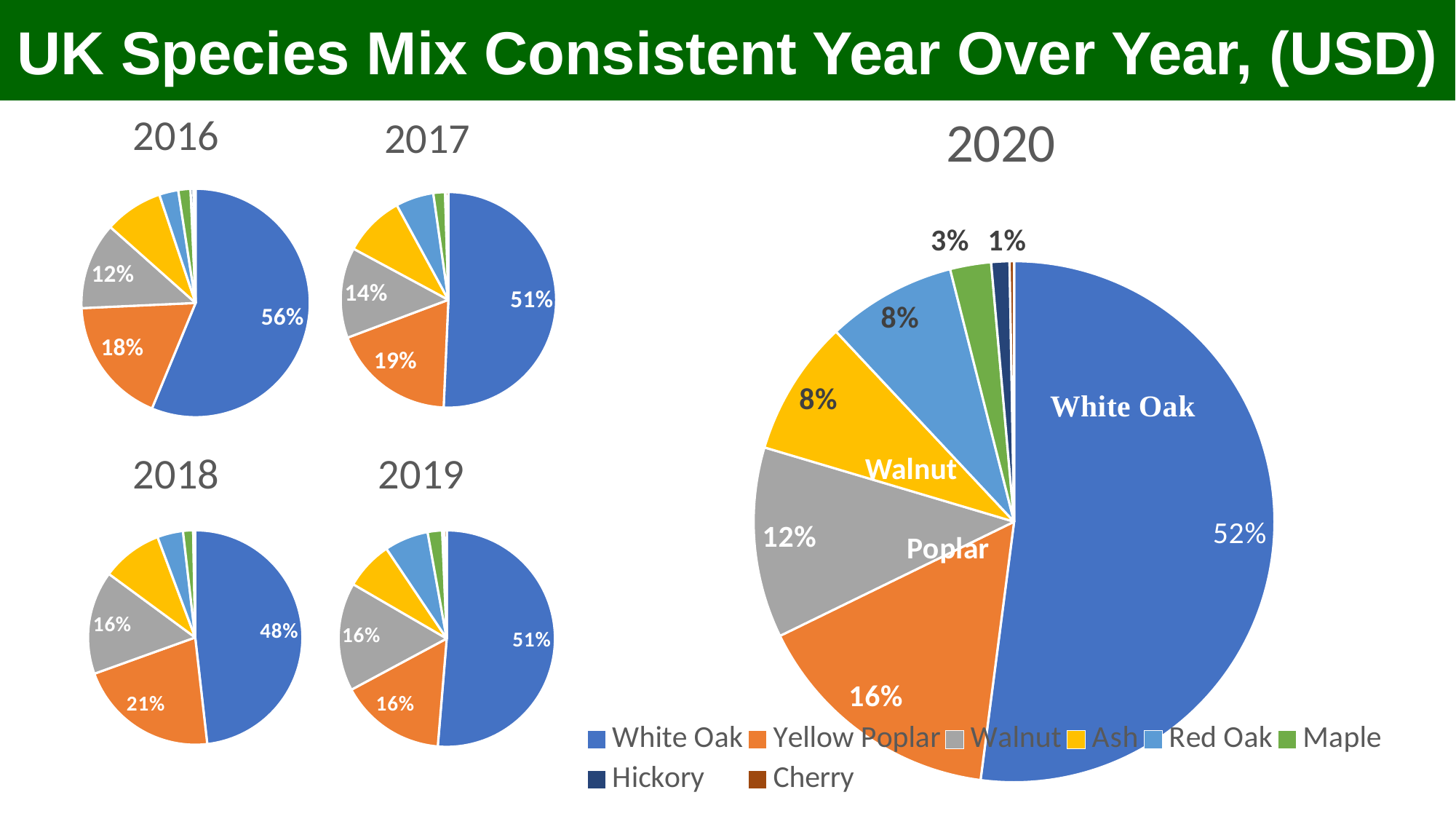
In the 2020 pie chart, what share does White Oak have? 52% How many species does the legend list? 8 In the 2018 pie chart, what is the value for Yellow Poplar? 21% What kind of charts are shown on the slide? Pie charts In the 2017 pie chart, what is the difference between the White Oak share and the Yellow Poplar share? 32% How many pie charts are on the slide? 5 In the 2020 pie chart, which labelled species has the smallest share? Hickory In the 2019 pie chart, which is larger, the White Oak share or the Walnut share? White Oak In the 2020 pie chart, what is the value for Maple? 3% In the 2020 pie chart, which species has the largest share? White Oak In the 2020 pie chart, what is the value for Walnut? 12% In the 2016 pie chart, what is the value for White Oak? 56%